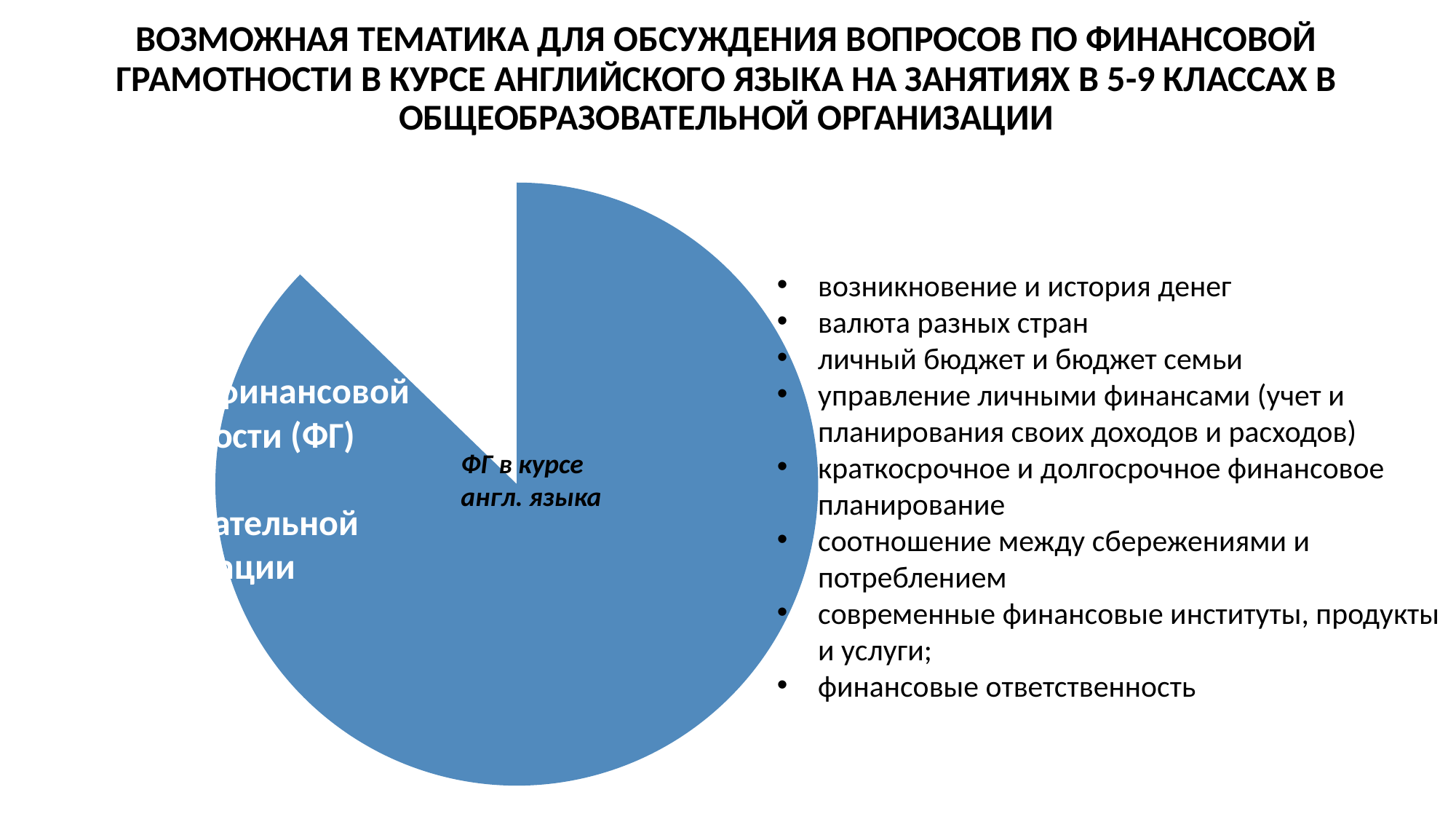
Does the blue slice labelled "ФГ в курсе англ. языка" cover more or less than half of the pie? more What kind of chart is shown on the slide? pie chart What label is printed inside the large blue slice of the pie chart? ФГ в курсе англ. языка What colour is the large slice of the pie chart? blue